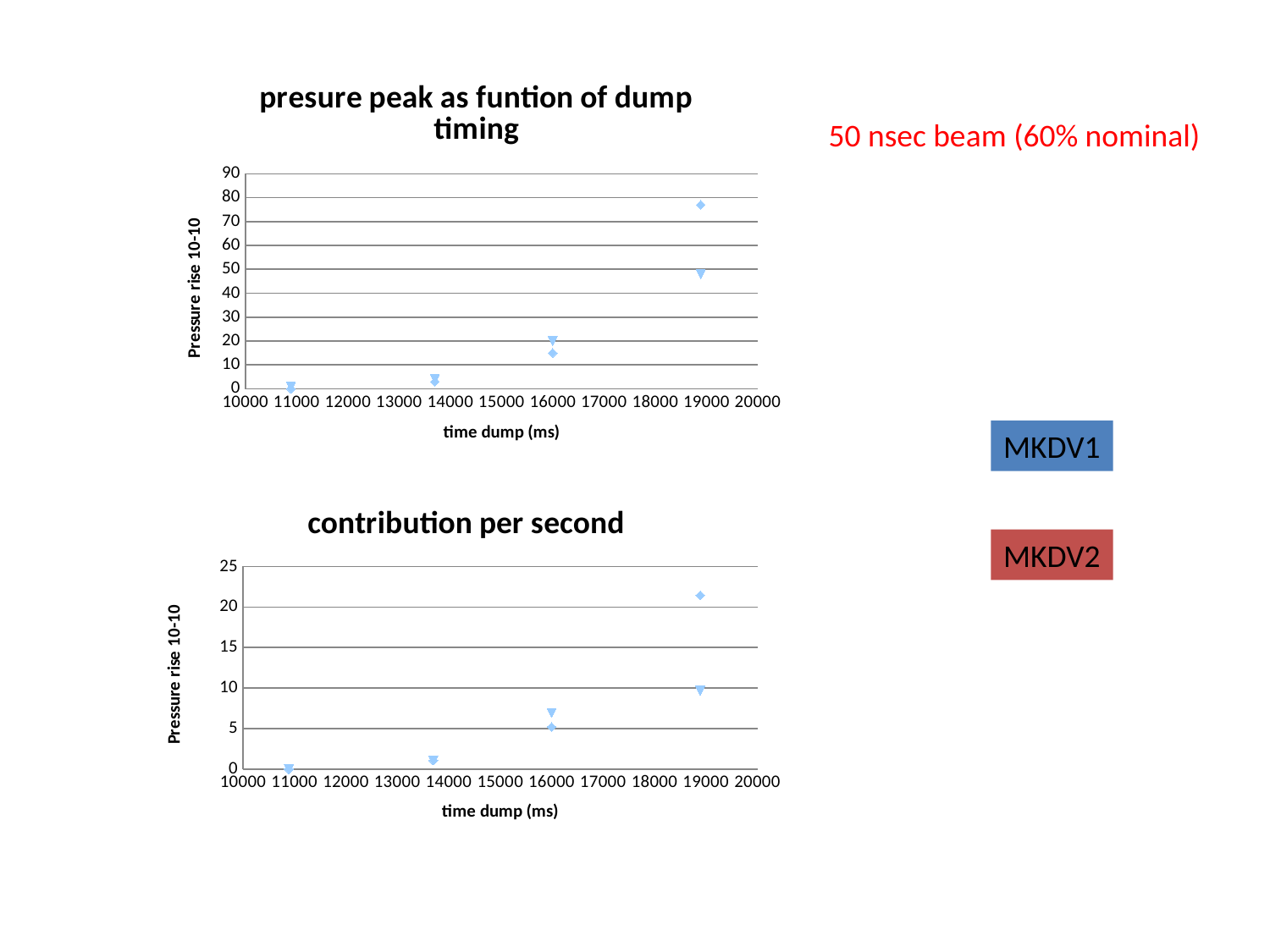
In the top chart "presure peak as funtion of dump timing", is the diamond-marker value at a dump time of about 16000 ms greater or less than 30? less In the top chart "presure peak as funtion of dump timing", do the plotted values rise or fall as the dump time increases? rise In the bottom chart "contribution per second", is the triangle-marker value at a dump time of about 16000 ms greater or less than 5? greater In the top chart "presure peak as funtion of dump timing", at about 19000 ms, which marker shows the larger value, the diamond or the triangle? diamond In the top chart "presure peak as funtion of dump timing", is the triangle-marker value at a dump time of about 19000 ms greater or less than 40? greater In the bottom chart "contribution per second", how many dump-time points are plotted for each marker series? 4 What is the x-axis title of the bottom chart "contribution per second"? time dump (ms) What kind of chart is the top chart titled "presure peak as funtion of dump timing"? scatter chart What is the highest value shown on the y-axis of the top chart "presure peak as funtion of dump timing"? 90